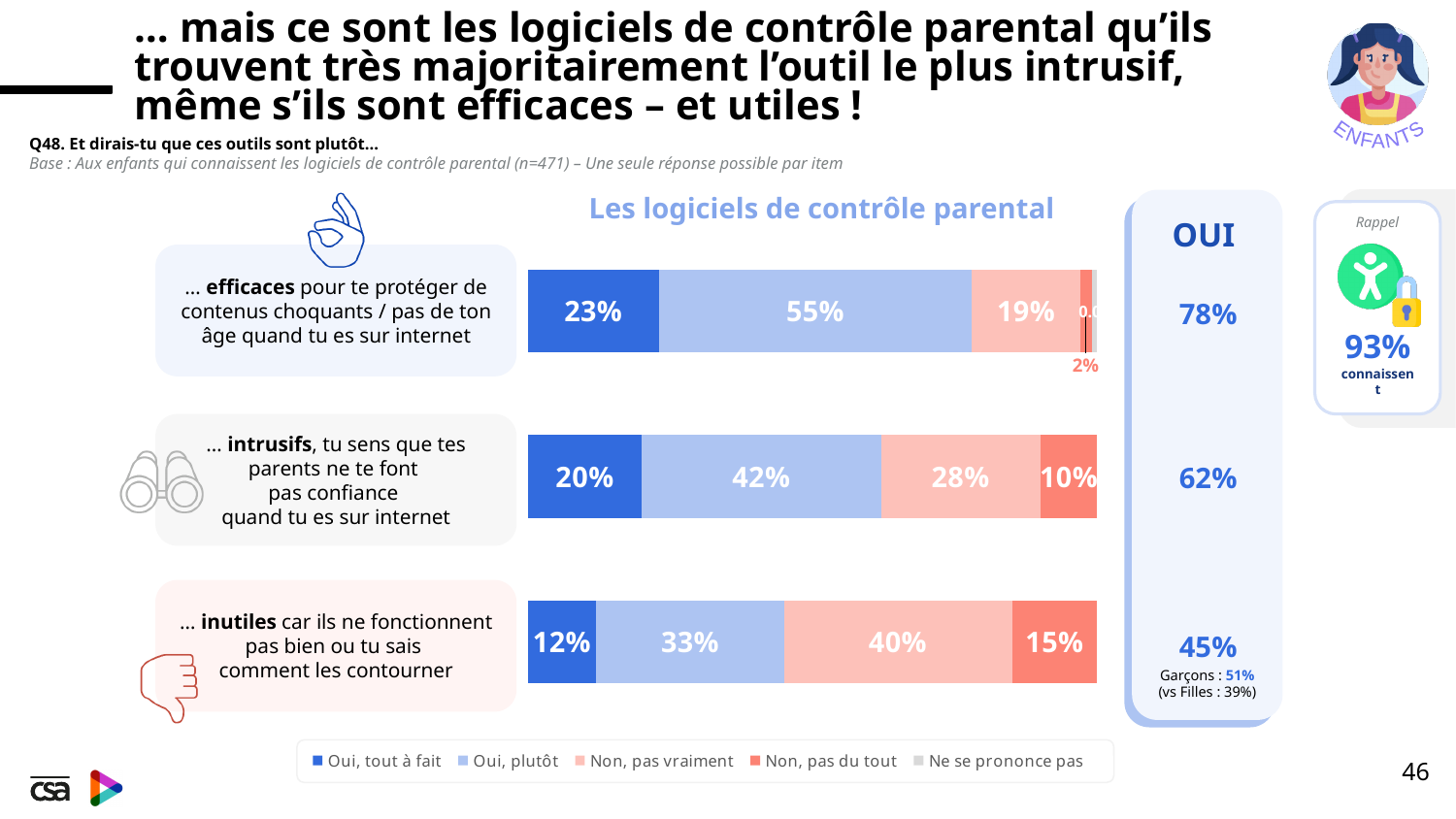
What is the difference between the "Oui, plutôt" values for "efficaces" and "inutiles"? 22% What is the "Oui, tout à fait" value for the item "efficaces"? 23% What is the "Non, pas vraiment" value for the item "inutiles"? 40% What is the "Oui, plutôt" value for the item "intrusifs"? 42% Which is larger: the "Non, pas du tout" value for "inutiles" or for "intrusifs"? inutiles What kind of chart is shown under the title "Les logiciels de contrôle parental"? stacked bar chart How many items (categories) are plotted in the chart? 3 How many series does the legend list? 5 Which item has the lowest "Oui, plutôt" value? inutiles What is the "Non, pas du tout" value for the item "intrusifs"? 10% Which item has the highest "Oui, tout à fait" value? efficaces What total "OUI" share is shown for the item "intrusifs"? 62%